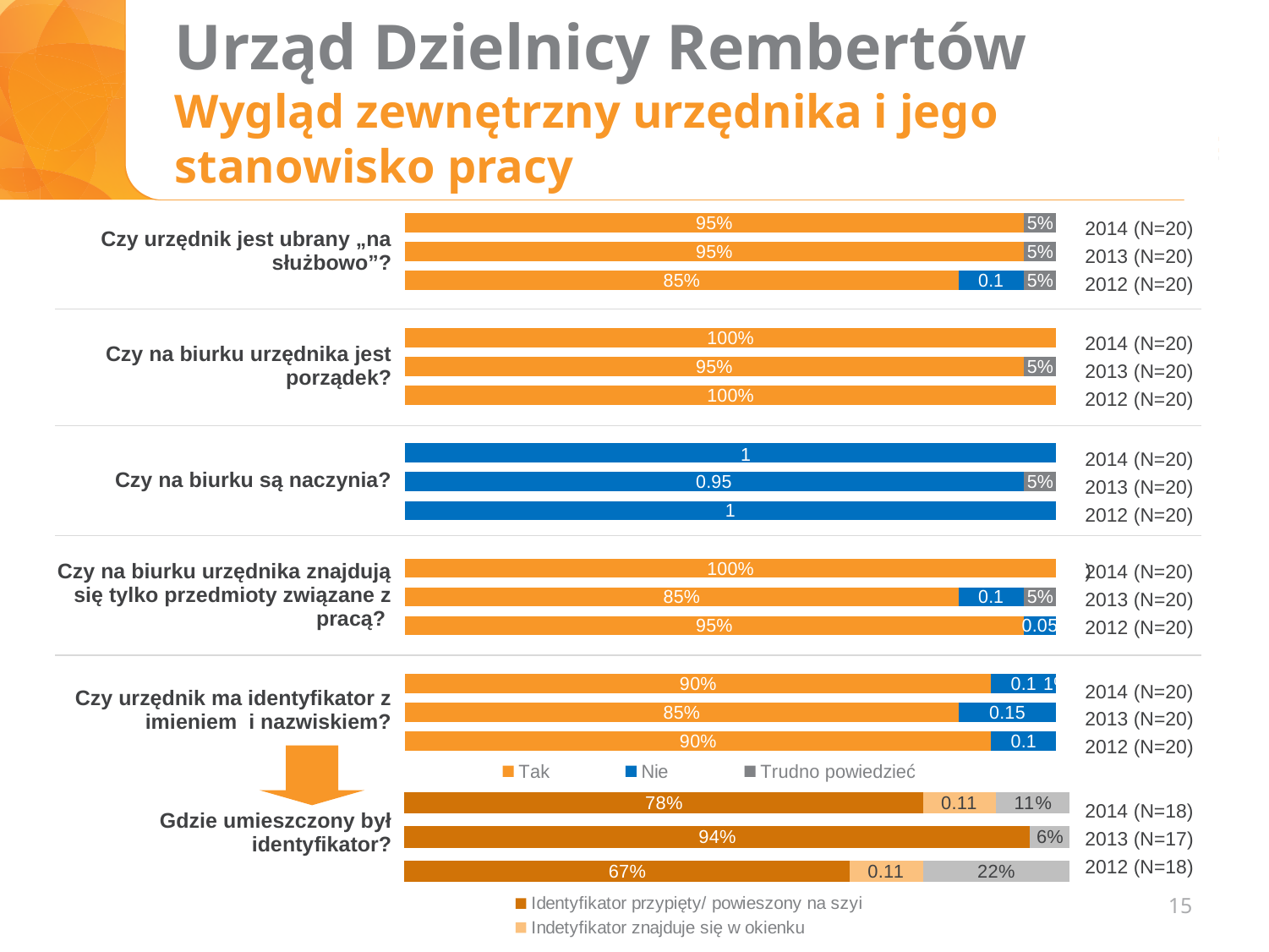
In the chart for "Gdzie umieszczony był identyfikator?", which year has the highest value for the first (dark orange) segment? 2013 (N=17) In the chart for "Czy urzędnik jest ubrany „na służbowo”?", what is the "Tak" value for 2014 (N=20)? 95% In the chart for "Czy na biurku urzędnika jest porządek?", what is the "Tak" value for 2013 (N=20)? 95% How many series does the legend above the "Gdzie umieszczony był identyfikator?" chart list (Tak / Nie / Trudno powiedzieć)? 3 In the chart for "Czy urzędnik ma identyfikator z imieniem i nazwiskiem?", what is the "Nie" value for 2013 (N=20)? 0.15 In the chart for "Gdzie umieszczony był identyfikator?", is the first segment value for 2014 (N=18) larger or smaller than for 2012 (N=18)? larger In the chart for "Czy na biurku są naczynia?", what is the value of the blue bar for 2013 (N=20)? 0.95 In the chart for "Czy urzędnik jest ubrany „na służbowo”?", what is the difference between the "Tak" values for 2014 and 2012? 10% In the chart for "Czy na biurku urzędnika jest porządek?", which year has the lowest "Tak" value? 2013 (N=20) In the chart for "Czy urzędnik jest ubrany „na służbowo”?", what is the "Tak" value for 2012 (N=20)? 85% In the chart for "Czy na biurku urzędnika znajdują się tylko przedmioty związane z pracą?", what is the "Tak" value for 2013 (N=20)? 85% In the chart for "Gdzie umieszczony był identyfikator?", what is the value of the first (dark orange) segment for 2013 (N=17)? 94%